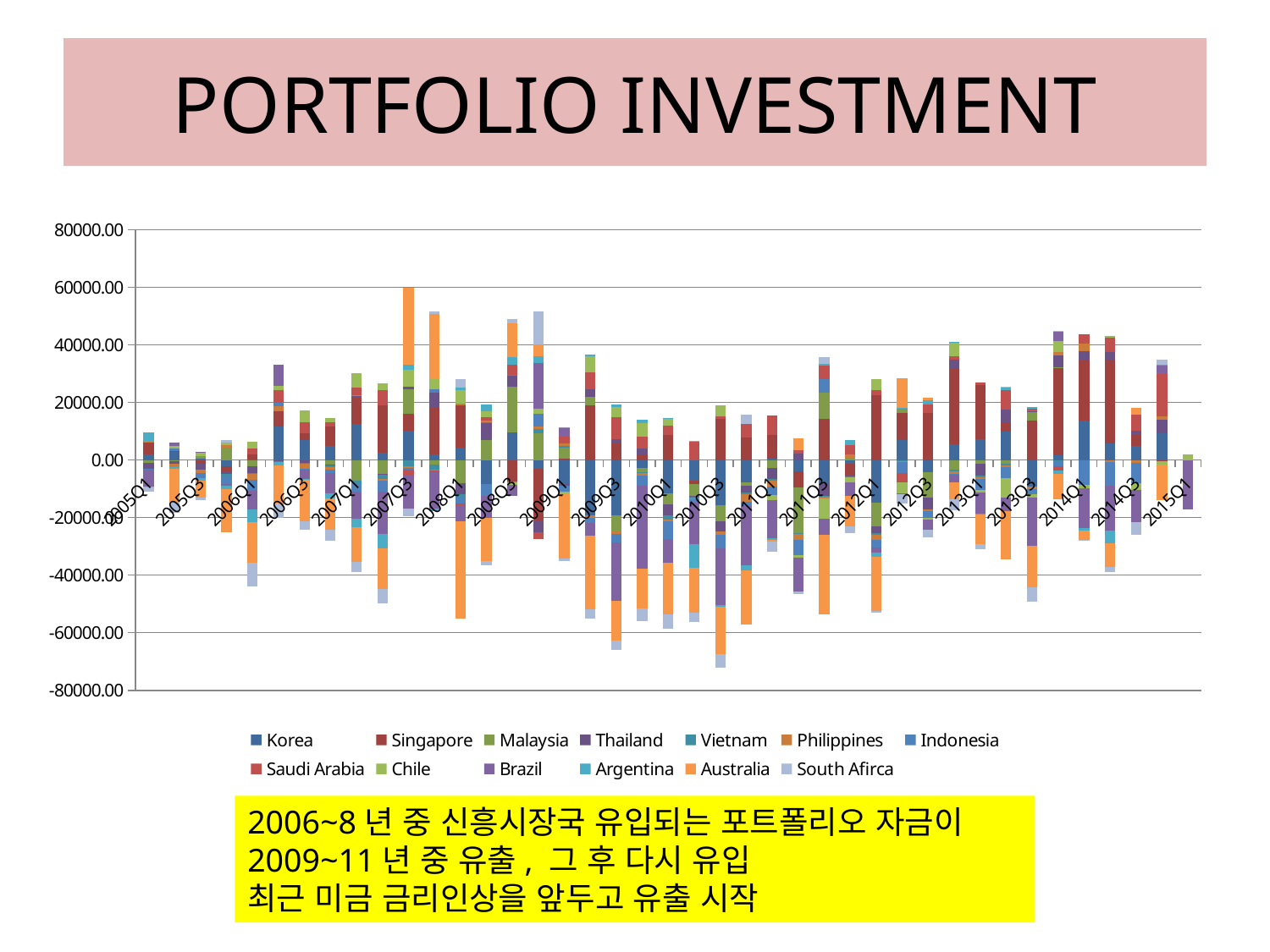
Which quarter has the taller positive stacked bar, 2008Q1 or 2005Q3? 2008Q1 Is the top of the positive stacked bar for 2008Q1 greater or less than 40000.00? less Which colour represents Australia in the legend? orange Which quarter has the deeper negative stacked bar, 2010Q3 or 2005Q1? 2010Q3 What is the title of the slide containing the chart? PORTFOLIO INVESTMENT How many series does the legend list? 13 What kind of chart is shown on the slide? bar chart Is the top of the positive stacked bar for 2005Q3 greater or less than 20000.00? less Is the top of the positive stacked bar for 2015Q1 greater or less than 20000.00? less